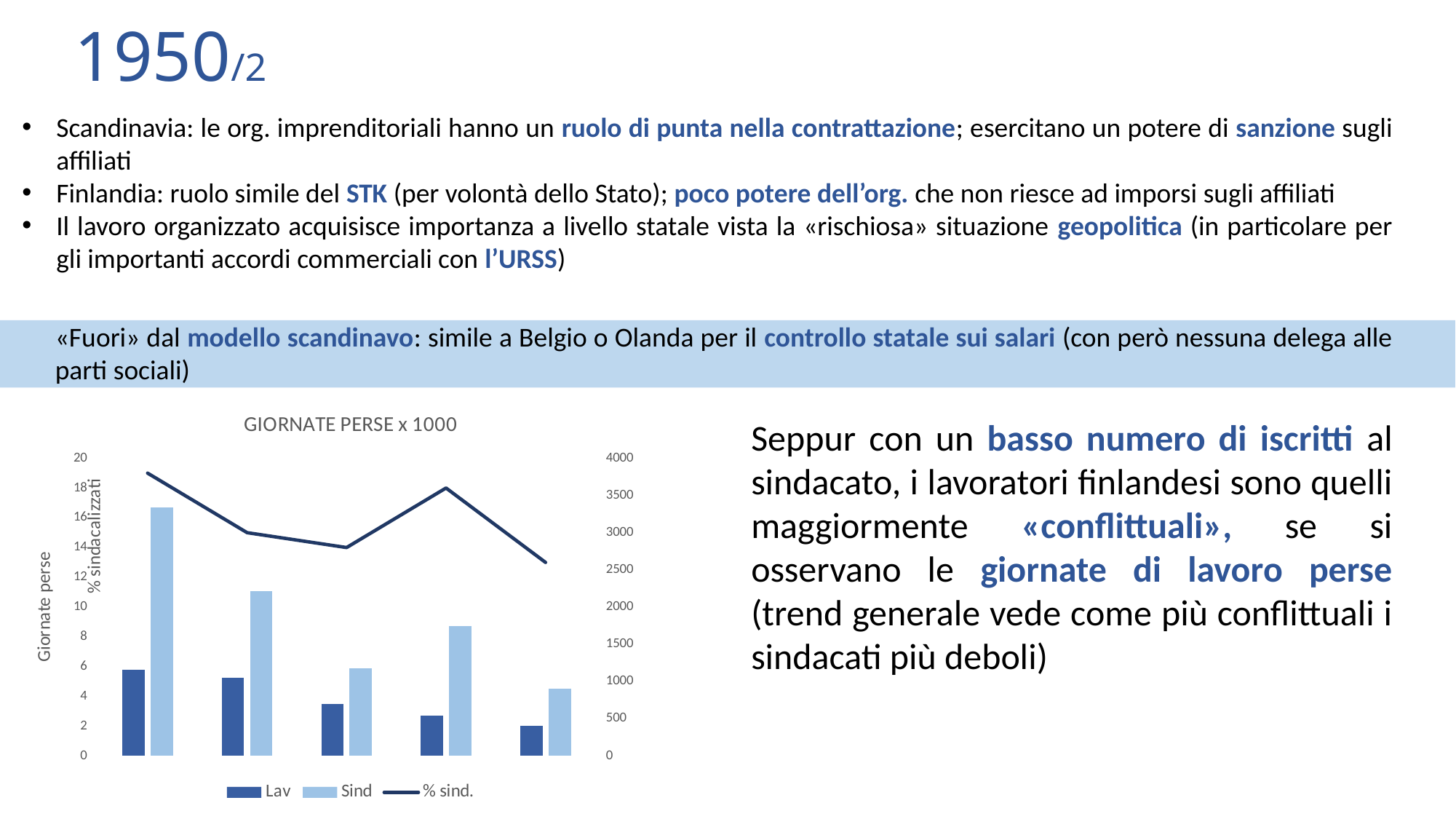
At which point is the % sind. line highest? The first (leftmost) point What kind of chart is shown on the slide? A combined bar and line chart Which group of bars has the shortest Lav bar? The rightmost (last) group How many series does the chart legend list? 3 What is the maximum value shown on the right-hand axis of the chart? 4000 In the leftmost group of bars, which is taller, the Lav bar or the Sind bar? Sind How many groups of bars are plotted in the chart? 5 What is the title of the chart on the slide? GIORNATE PERSE x 1000 Which group of bars has the tallest Sind bar? The leftmost (first) group What are the three series named in the chart legend? Lav, Sind, % sind. Do the Lav bars generally rise or fall from left to right? Fall At which point is the % sind. line lowest? The last (rightmost) point